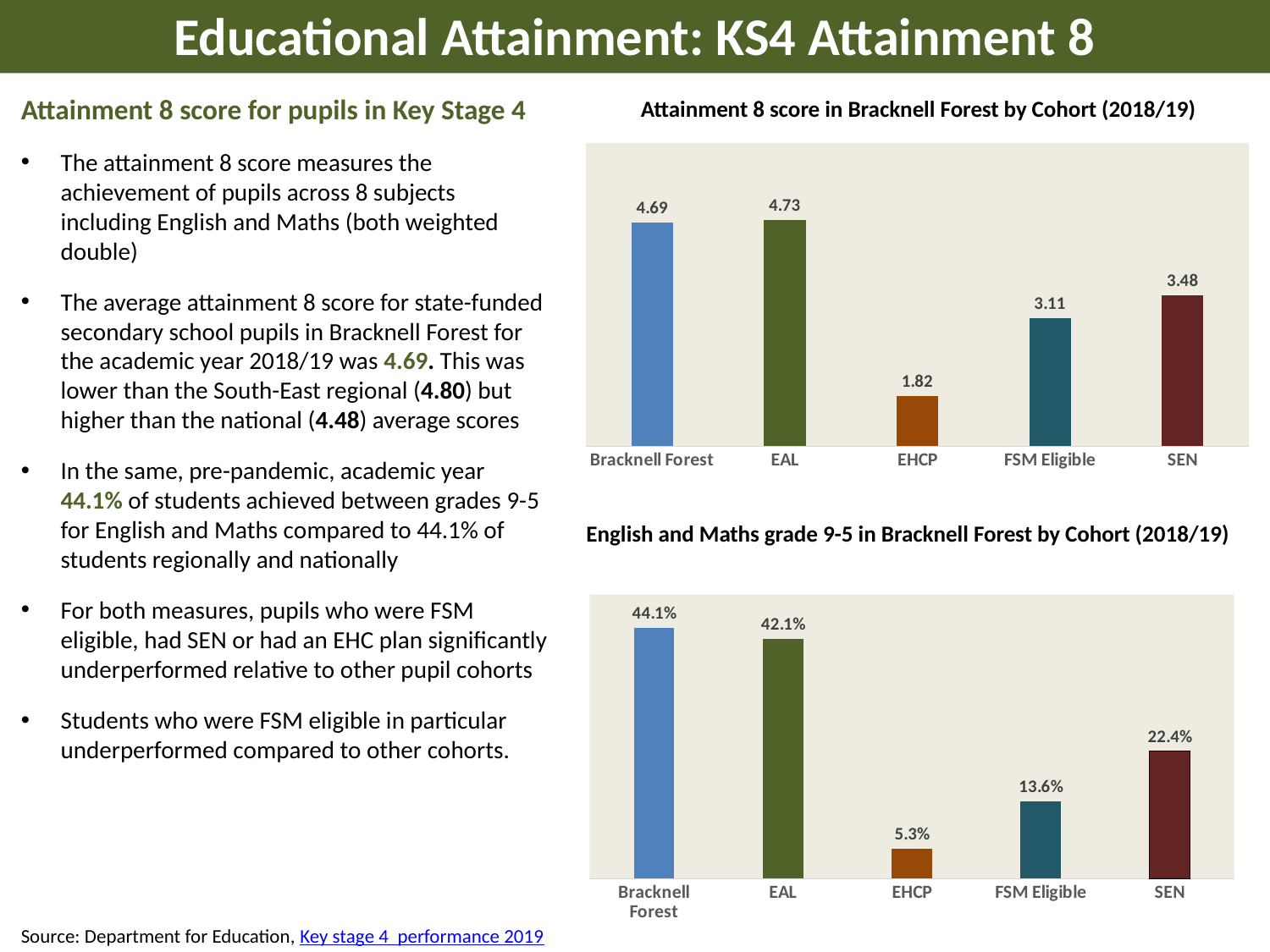
In the 'Attainment 8 score in Bracknell Forest by Cohort (2018/19)' chart, what is the difference between the Bracknell Forest and FSM Eligible values? 1.58 In the 'Attainment 8 score in Bracknell Forest by Cohort (2018/19)' chart, which cohort has the highest score? EAL In the 'Attainment 8 score in Bracknell Forest by Cohort (2018/19)' chart, how many cohorts are shown? 5 In the 'English and Maths grade 9-5 in Bracknell Forest by Cohort (2018/19)' chart, what is the value for FSM Eligible? 13.6% In the 'English and Maths grade 9-5 in Bracknell Forest by Cohort (2018/19)' chart, what is the difference between the Bracknell Forest and EAL values? 2.0% In the 'English and Maths grade 9-5 in Bracknell Forest by Cohort (2018/19)' chart, what is the value for SEN? 22.4% In the 'Attainment 8 score in Bracknell Forest by Cohort (2018/19)' chart, what is the value for EHCP? 1.82 In the 'English and Maths grade 9-5 in Bracknell Forest by Cohort (2018/19)' chart, which cohort has the highest value? Bracknell Forest What kind of chart is the 'Attainment 8 score in Bracknell Forest by Cohort (2018/19)' chart? Bar chart In the 'English and Maths grade 9-5 in Bracknell Forest by Cohort (2018/19)' chart, which is larger, the value for SEN or the value for FSM Eligible? SEN In the 'Attainment 8 score in Bracknell Forest by Cohort (2018/19)' chart, what colour is the EHCP bar? Orange/brown In the 'Attainment 8 score in Bracknell Forest by Cohort (2018/19)' chart, which cohort has the lowest score? EHCP